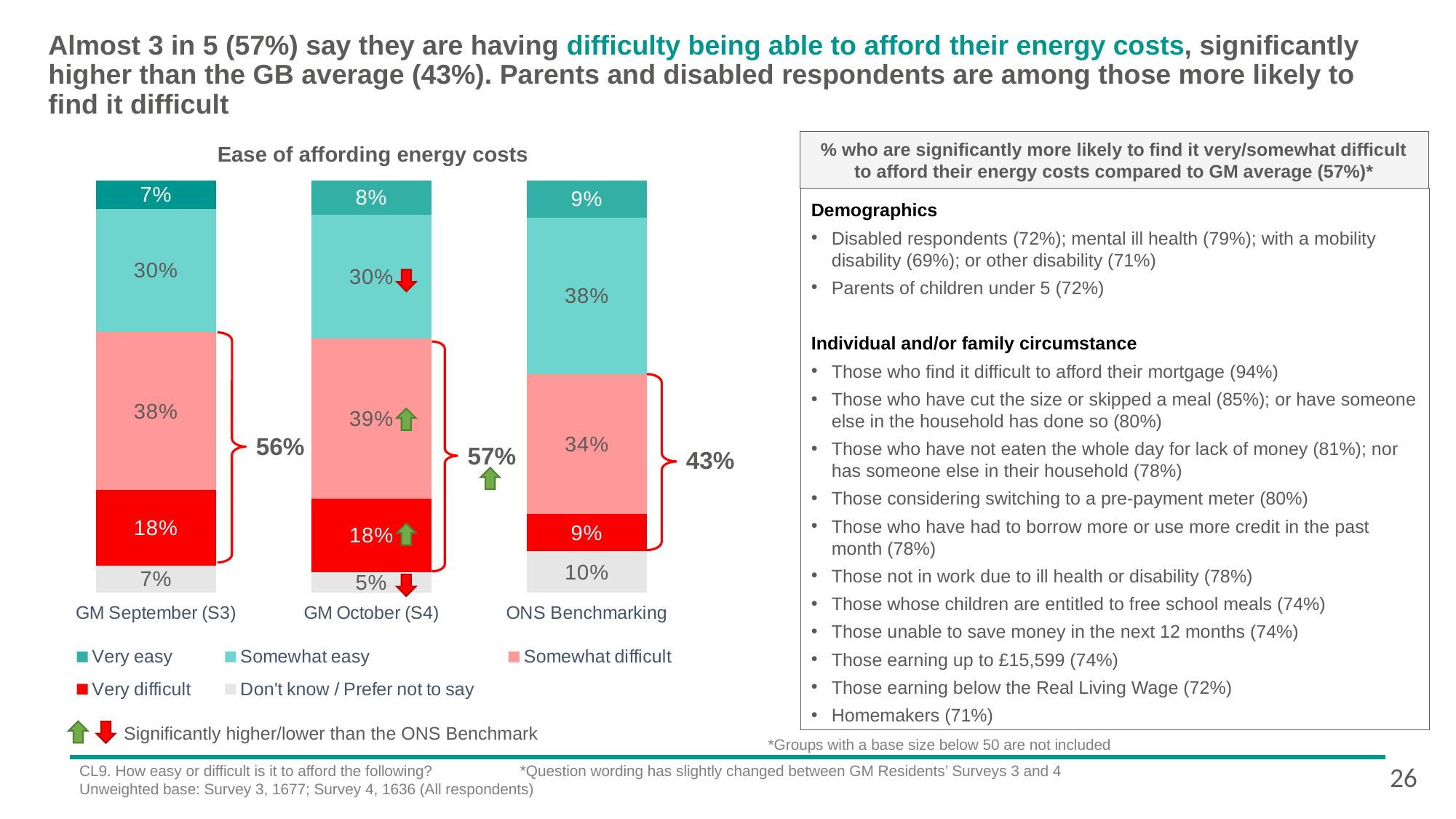
What is the combined 'Somewhat difficult' and 'Very difficult' total shown for GM October (S4)? 57% What is the difference between the 'Very difficult' values for GM October (S4) and ONS Benchmarking? 9 percentage points Is the 'Somewhat difficult' value larger for GM September (S3) or ONS Benchmarking? GM September (S3) What is the 'Somewhat difficult' value for GM October (S4)? 39% What is the 'Somewhat easy' value for ONS Benchmarking? 38% Which category has the lowest 'Don't know / Prefer not to say' value? GM October (S4) What is the 'Don't know / Prefer not to say' value for GM September (S3)? 7% Which category has the highest 'Very easy' value? ONS Benchmarking What is the 'Very difficult' value for ONS Benchmarking? 9% How many series does the legend of the 'Ease of affording energy costs' chart list? 5 How many categories (bars) are shown in the 'Ease of affording energy costs' chart? 3 What type of chart is 'Ease of affording energy costs'? Stacked bar chart